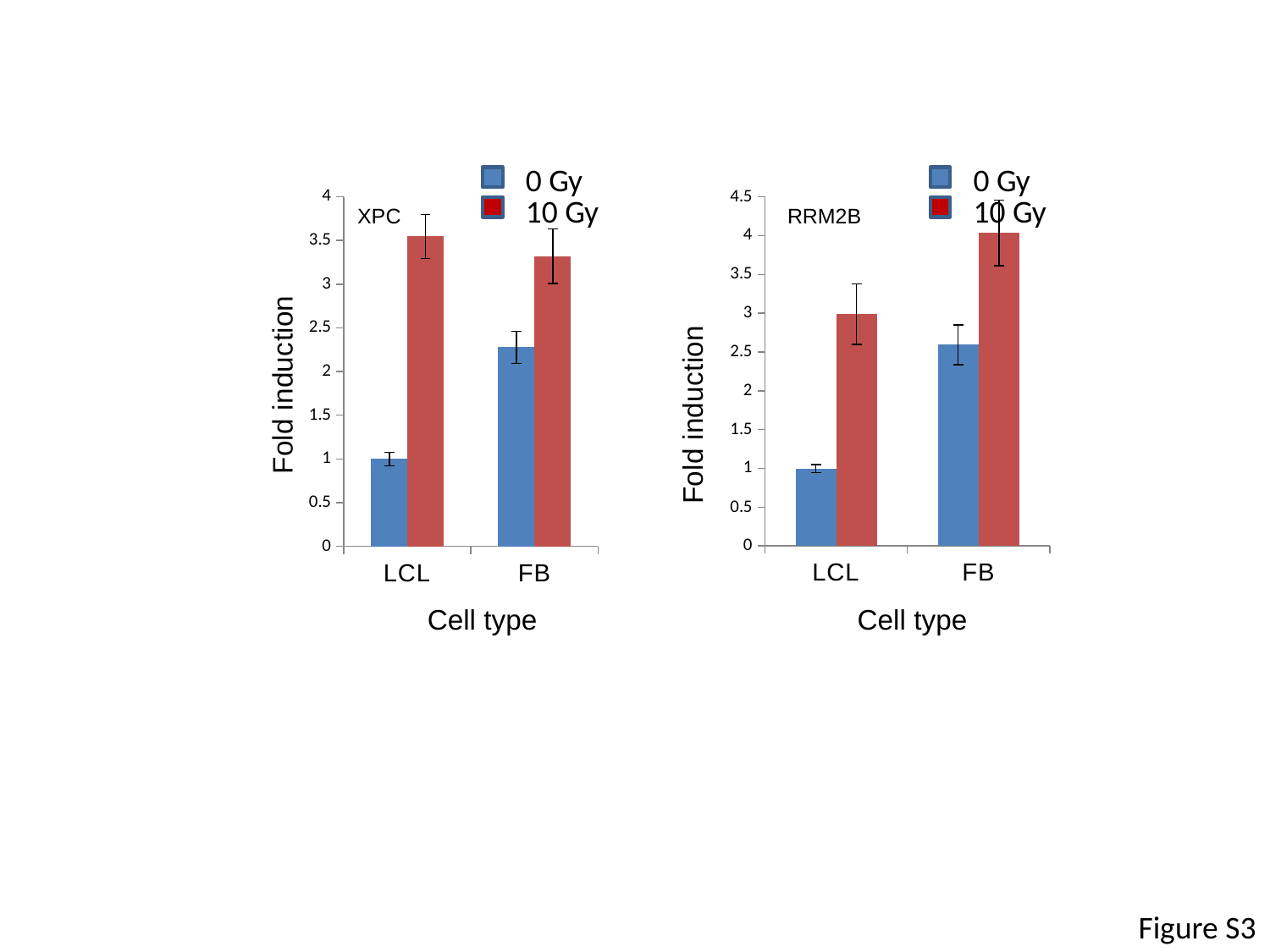
In the RRM2B chart, which is larger at 10 Gy: LCL or FB? FB In the XPC chart, is the 10 Gy value for LCL greater or less than 3? greater In the RRM2B chart, which bar is the tallest? FB at 10 Gy In the XPC chart, is the 0 Gy value for FB greater or less than 2? greater In the RRM2B chart, is the 10 Gy value for LCL greater or less than 2.5? greater In the XPC chart, which bar is the tallest? LCL at 10 Gy How many cell type categories are shown on the x axis of the RRM2B chart? 2 In the XPC chart, which bar is the shortest? LCL at 0 Gy In the XPC chart, which is larger at 0 Gy: LCL or FB? FB How many series does the legend of the XPC chart list? 2 What kind of chart is the XPC chart on the left? bar chart What is the y-axis title of the RRM2B chart? Fold induction